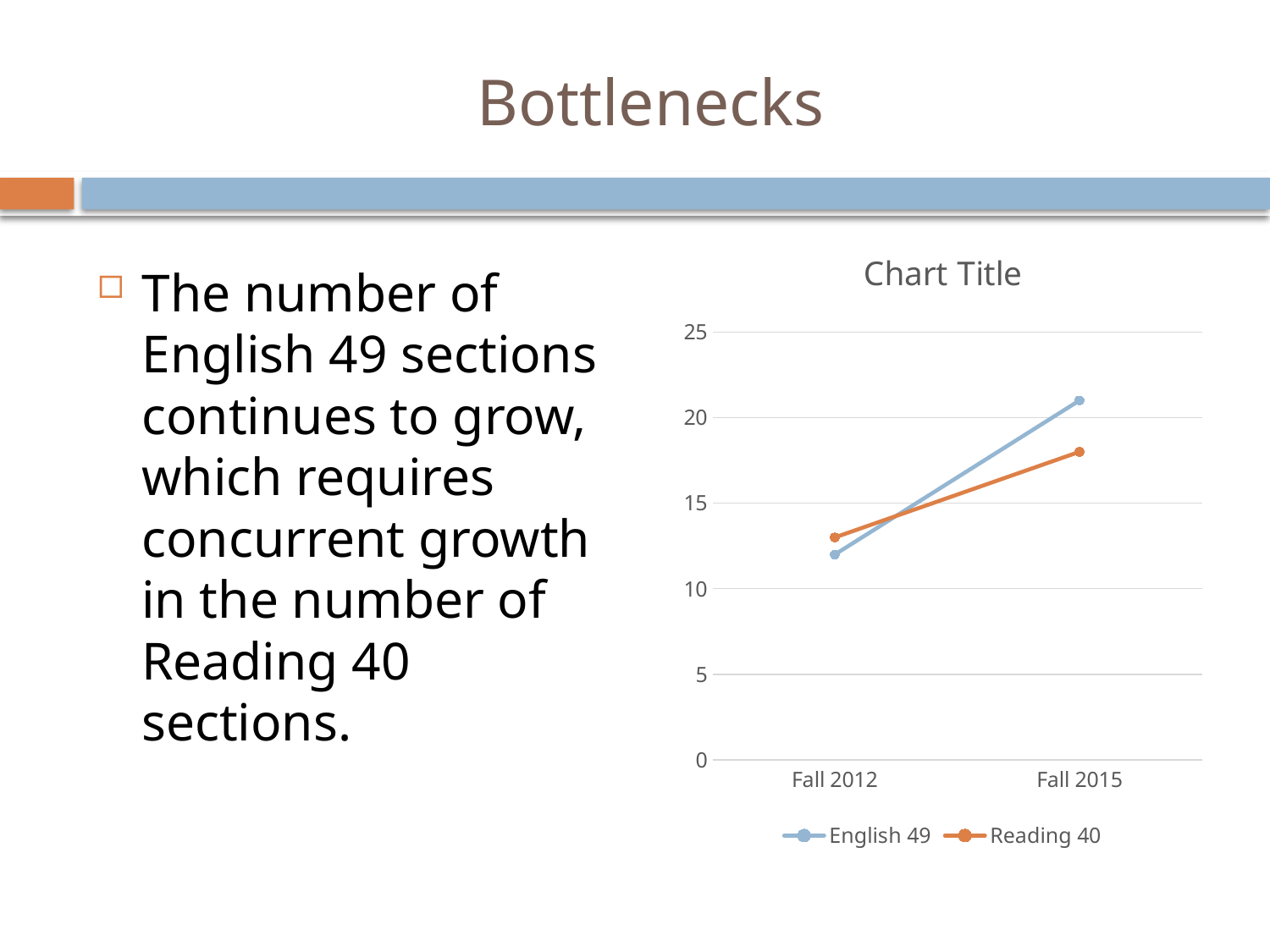
Which series is drawn in orange in the chart? Reading 40 Is the value for Reading 40 in Fall 2012 greater or less than 10? greater What is the title shown above the chart? Chart Title Is the value for English 49 in Fall 2015 greater or less than 20? greater Does the English 49 line rise or fall from Fall 2012 to Fall 2015? rise Does the Reading 40 line rise or fall from Fall 2012 to Fall 2015? rise How many series does the chart legend list? 2 In Fall 2015, which series has the higher value, English 49 or Reading 40? English 49 Is the value for Reading 40 in Fall 2015 greater or less than 20? less How many categories are shown on the x axis of the chart? 2 What kind of chart is shown on the slide? line chart